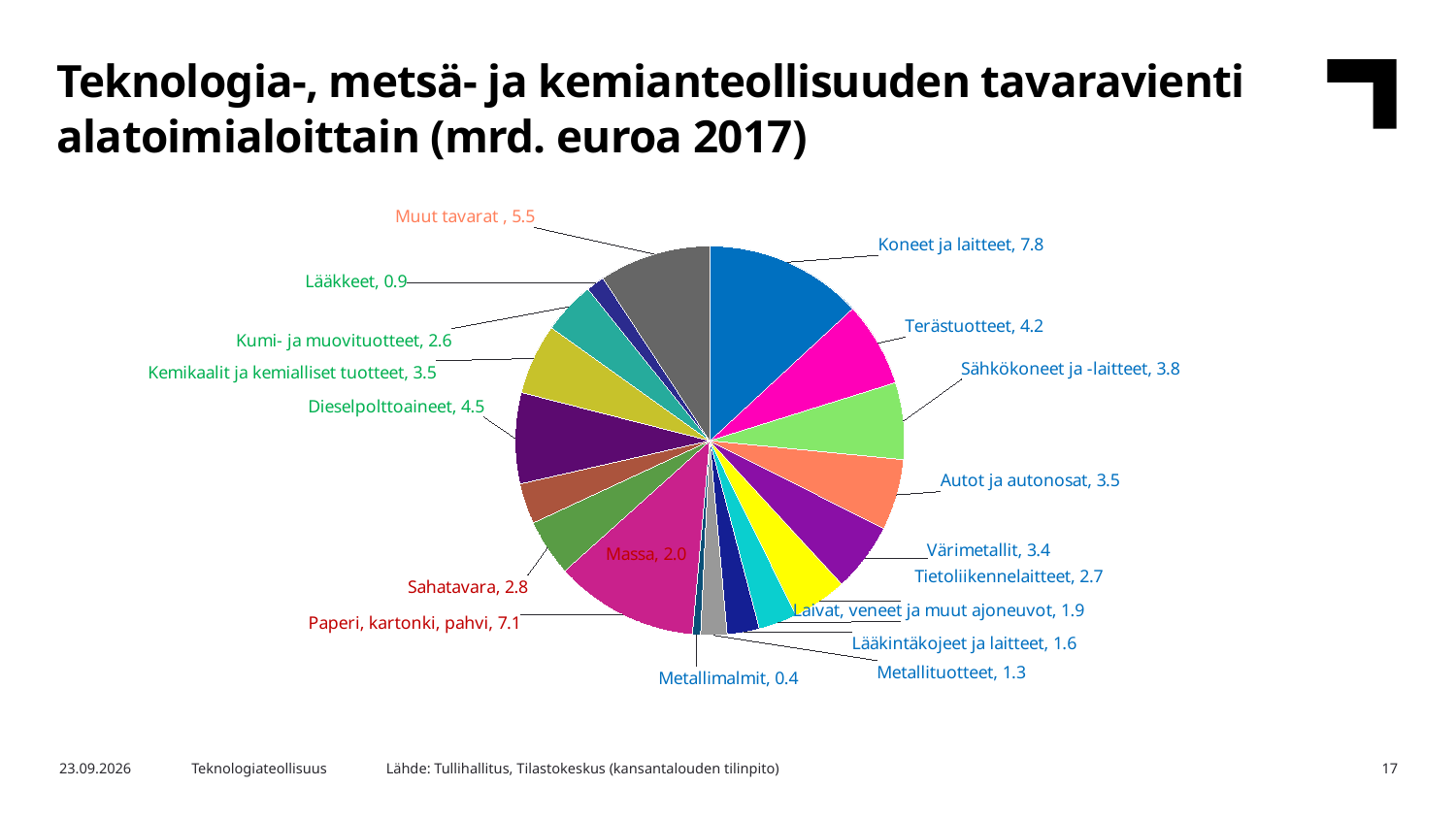
How many categories are shown in the pie chart? 18 What is the value for Metallimalmit? 0.4 What kind of chart is shown on the slide? Pie chart Which is larger, Sähkökoneet ja -laitteet or Värimetallit? Sähkökoneet ja -laitteet What is the value for Koneet ja laitteet? 7.8 What is the difference between the values for Muut tavarat and Sahatavara? 2.7 Which category has the largest slice of the pie? Koneet ja laitteet Which category has the smallest slice of the pie? Metallimalmit What unit and year does the chart title state the values are in? mrd. euroa 2017 What is the value for Paperi, kartonki, pahvi? 7.1 What is the difference between the values for Koneet ja laitteet and Terästuotteet? 3.6 What is the value for Dieselpolttoaineet? 4.5